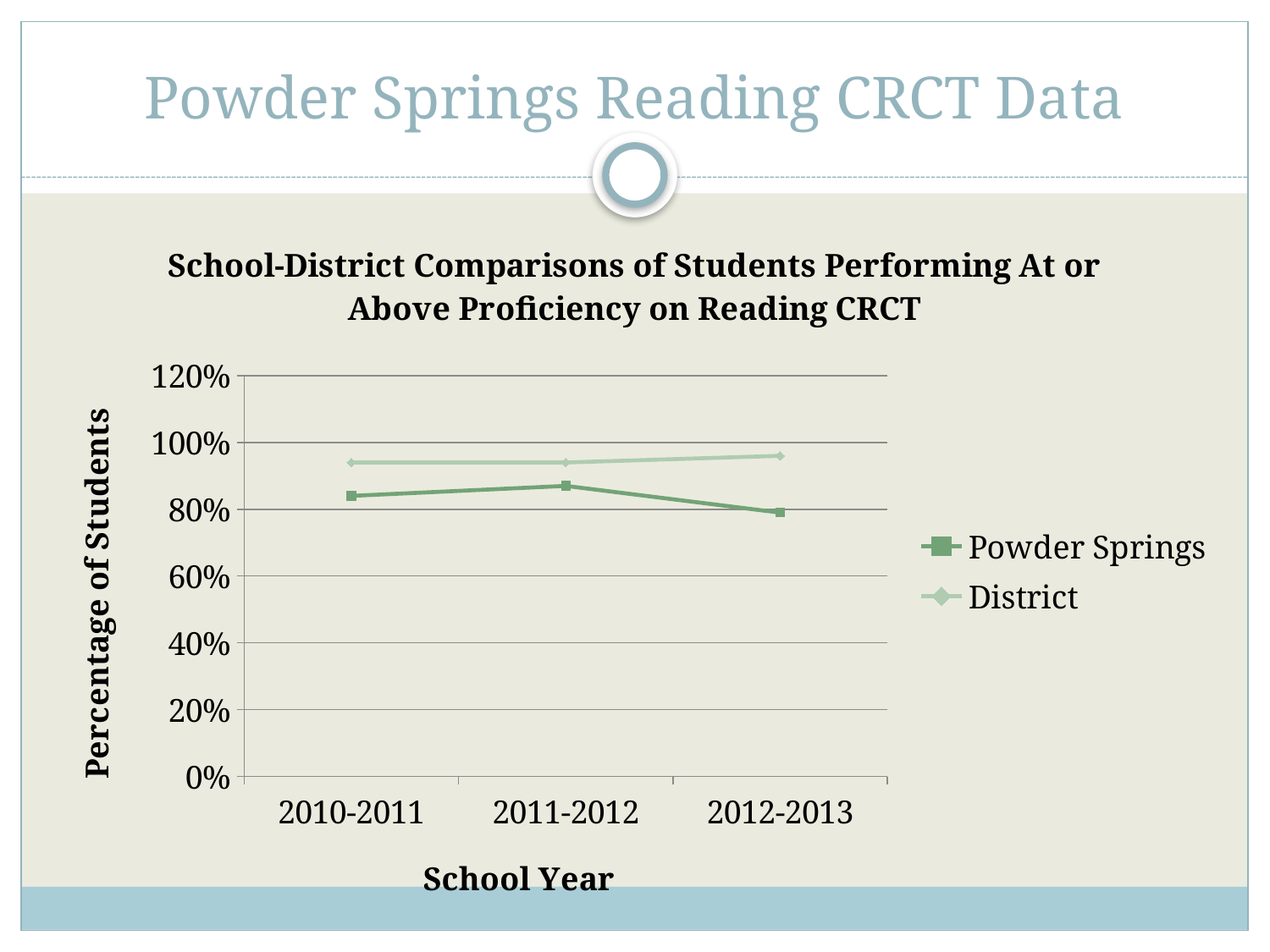
In which school year is the Powder Springs value lowest? 2012-2013 Is the District value for 2012-2013 greater or less than 80%? greater Is the Powder Springs value for 2011-2012 greater or less than 80%? greater Is the District value for 2010-2011 greater or less than 100%? less In which school year is the Powder Springs value highest? 2011-2012 What is the label of the y axis? Percentage of Students How many series does the legend list? 2 How many school years are plotted on the x axis? 3 What kind of chart is shown on the slide? Line chart Does the Powder Springs line rise or fall from 2011-2012 to 2012-2013? fall Which series is higher in 2012-2013, Powder Springs or District? District Which series is higher in 2010-2011, Powder Springs or District? District